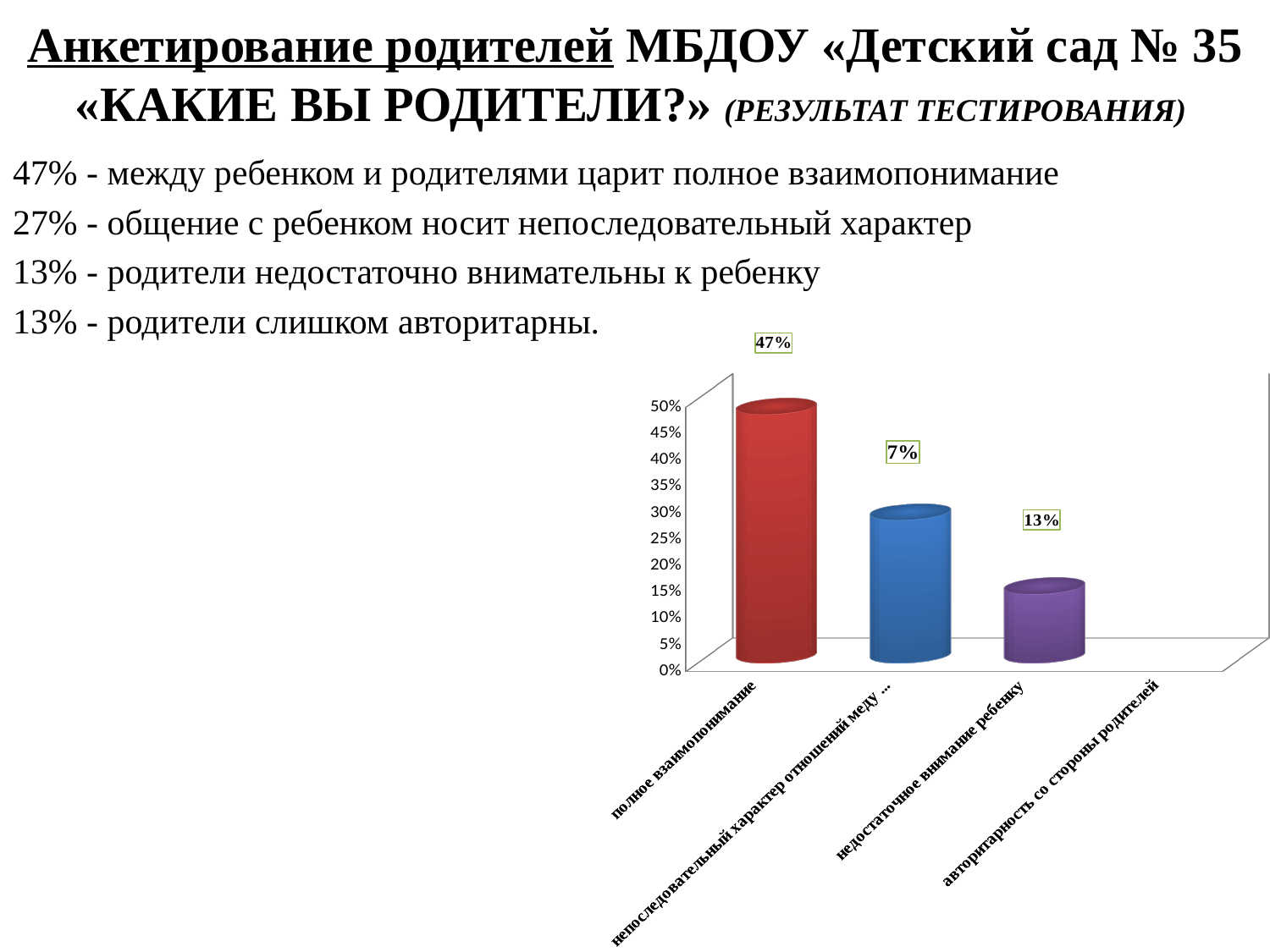
What value is shown for the bar labelled «недостаточное внимание ребенку»? 13% Which of the plotted bars is the lowest? недостаточное внимание ребенку What is the difference between the values for «полное взаимопонимание» and «недостаточное внимание ребенку»? 34% Do the bar values rise or fall from left to right along the x axis? fall How many bars are plotted in the chart? 3 Is the value for «недостаточное внимание ребенку» greater or less than 20%? less What colour is the tallest bar in the chart? red Which is larger: the bar for «полное взаимопонимание» or the bar for «недостаточное внимание ребенку»? полное взаимопонимание Which category has the tallest bar in the chart? полное взаимопонимание Is the value for «непоследовательный характер отношений» greater or less than 20%? greater What kind of chart is shown on the slide? bar chart What value is shown for the bar labelled «полное взаимопонимание»? 47%